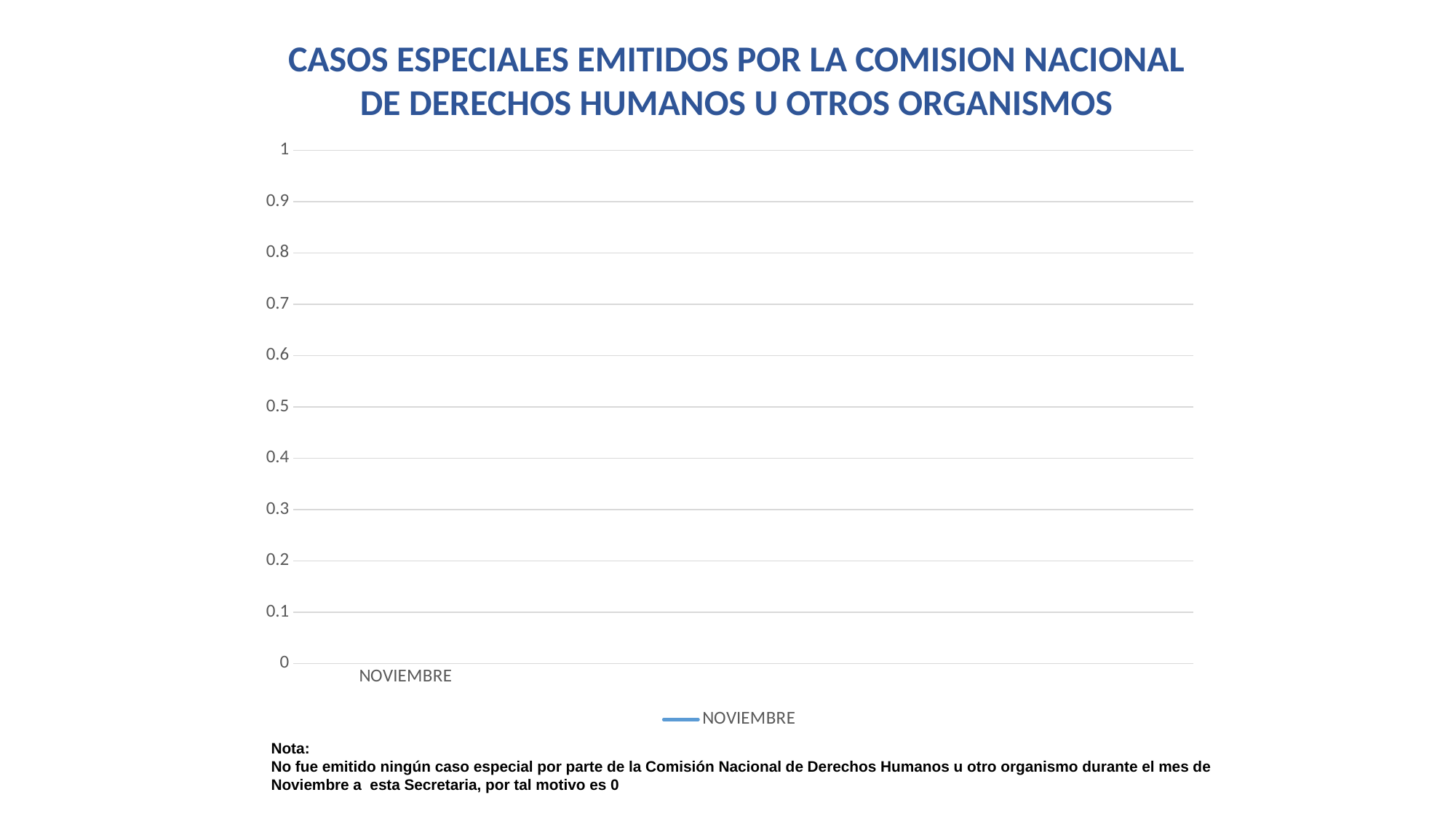
What kind of chart is shown on the slide? line chart What is the highest value shown on the chart's vertical axis? 1 What is the label of the only category on the x axis? NOVIEMBRE What is the value for NOVIEMBRE according to the slide? 0 What is the name of the series listed in the chart's legend? NOVIEMBRE Is the value for NOVIEMBRE greater or less than 0.5? less How many categories are shown on the x axis of the chart? 1 What is the title of the chart? CASOS ESPECIALES EMITIDOS POR LA COMISION NACIONAL DE DERECHOS HUMANOS U OTROS ORGANISMOS How many series does the chart's legend list? 1